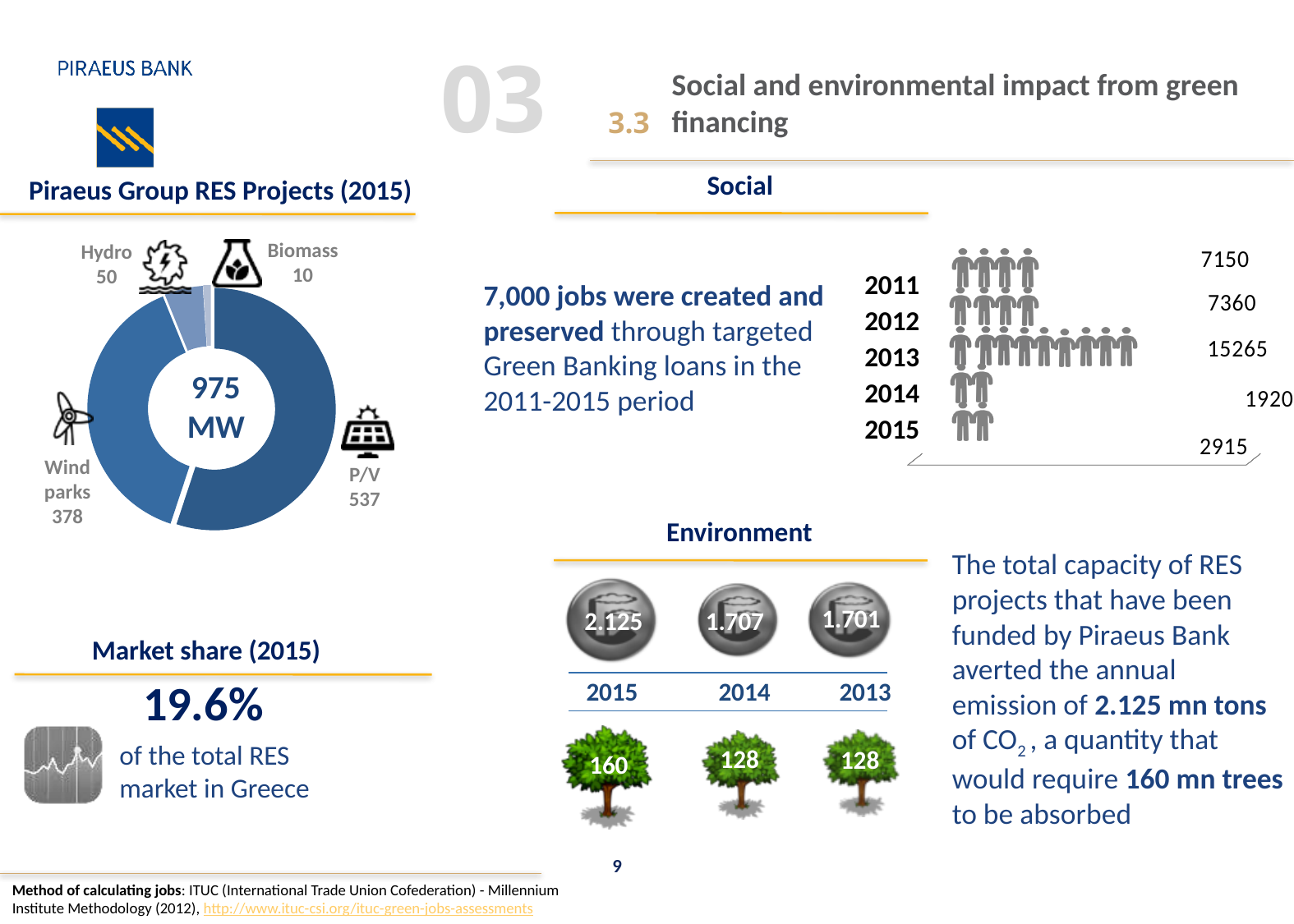
In the Piraeus Group RES Projects (2015) chart, which category has the largest value? P/V In the Social jobs chart, which year has the lowest number of jobs? 2014 In the Piraeus Group RES Projects (2015) chart, how many categories are shown? 4 In the Social jobs chart, how many jobs are shown for 2013? 15265 In the Environment chart, what is the CO2 value shown for 2014? 1.707 What total is shown in the centre of the Piraeus Group RES Projects (2015) chart? 975 MW What kind of chart is the Piraeus Group RES Projects (2015) chart? Donut (pie) chart In the Piraeus Group RES Projects (2015) chart, what is the value for P/V? 537 In the Piraeus Group RES Projects (2015) chart, what is the value for Wind parks? 378 In the Piraeus Group RES Projects (2015) chart, which category has the smallest value? Biomass In the Piraeus Group RES Projects (2015) chart, what is the difference between the P/V and Wind parks values? 159 In the Social jobs chart, what is the difference between the 2013 and 2012 values? 7905